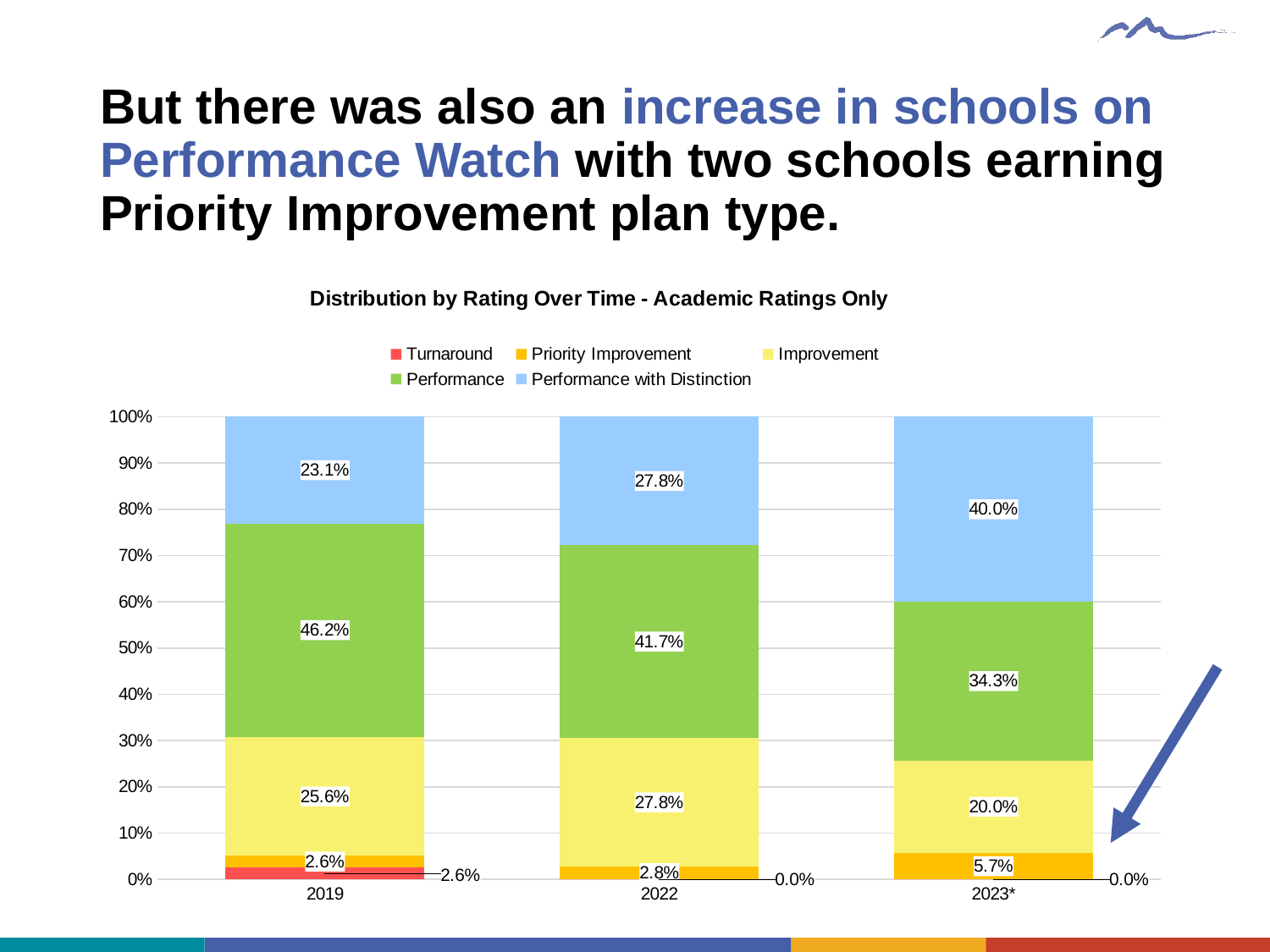
How many series does the legend list? 5 What is the Improvement value for 2023*? 20.0% Which is larger, the Improvement value in 2022 or the Improvement value in 2023*? 2022 What is the title of the chart? Distribution by Rating Over Time - Academic Ratings Only What is the Priority Improvement value for 2022? 2.8% What is the Performance with Distinction value for 2023*? 40.0% Which year has the lowest Priority Improvement value? 2019 How many years (categories) are shown on the x axis? 3 What is the difference between the Performance value in 2019 and in 2023*? 11.9% Which year has the highest Performance with Distinction value? 2023* What type of chart is shown on the slide? Stacked bar chart What is the Performance value for 2019? 46.2%